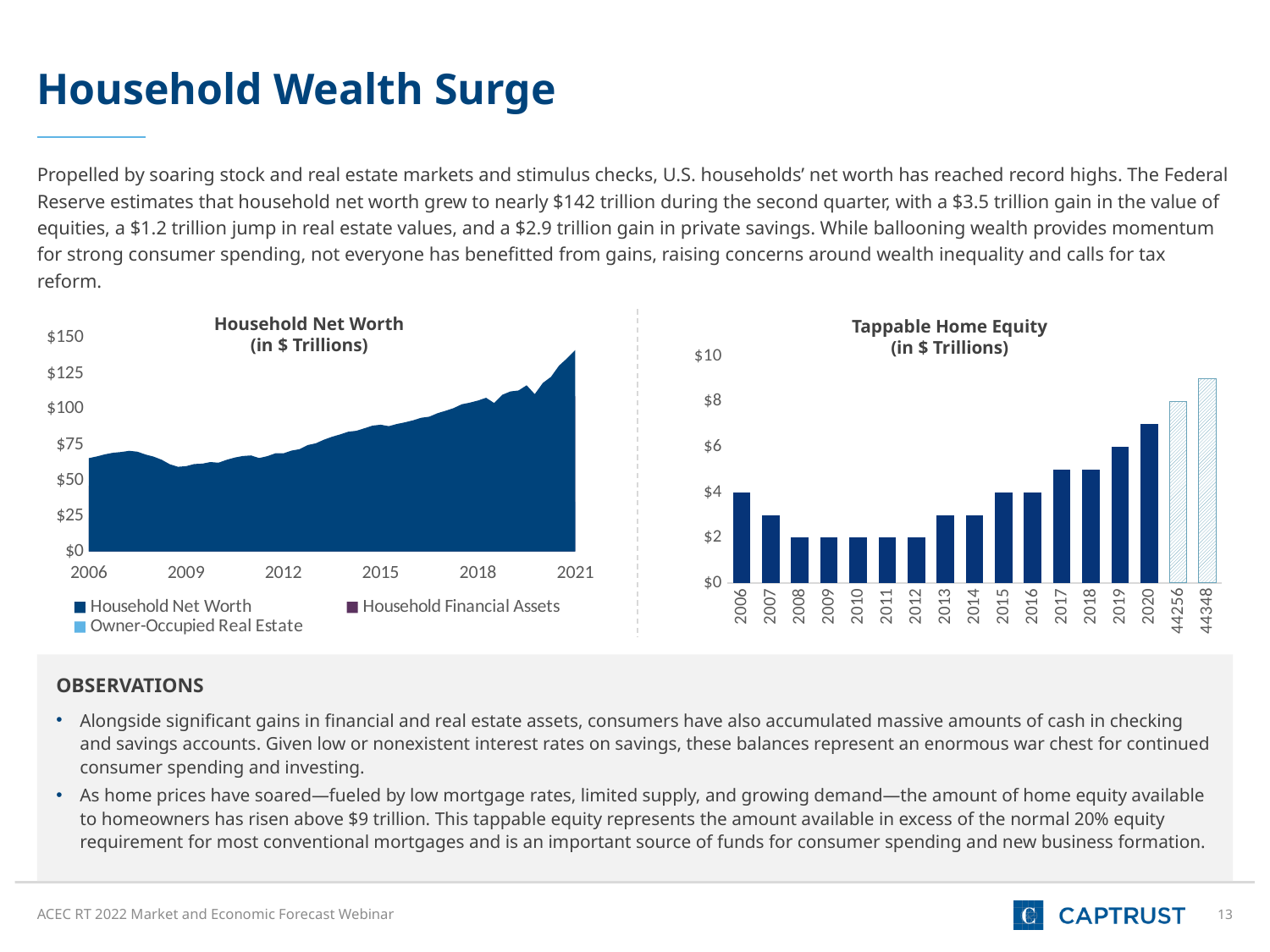
What kind of chart is the Household Net Worth chart? area chart In the Tappable Home Equity chart, how many bars are plotted? 17 In the Tappable Home Equity chart, which category has the highest value? 44348 What is the highest value shown on the y axis of the Tappable Home Equity chart? $10 In the Tappable Home Equity chart, is the value for 2006 greater or less than $2? greater In the Tappable Home Equity chart, which is larger, the value for 2020 or the value for 2015? 2020 In the Household Net Worth chart, does household net worth rise or fall overall from 2006 to 2021? rise In the Tappable Home Equity chart, do the values rise or fall from 2012 to 44348? rise How many series does the legend of the Household Net Worth chart list? 3 In the Tappable Home Equity chart, is the value for 2010 greater or less than $4? less What kind of chart is the Tappable Home Equity chart? bar chart In the Tappable Home Equity chart, is the value for 2019 greater or less than $4? greater